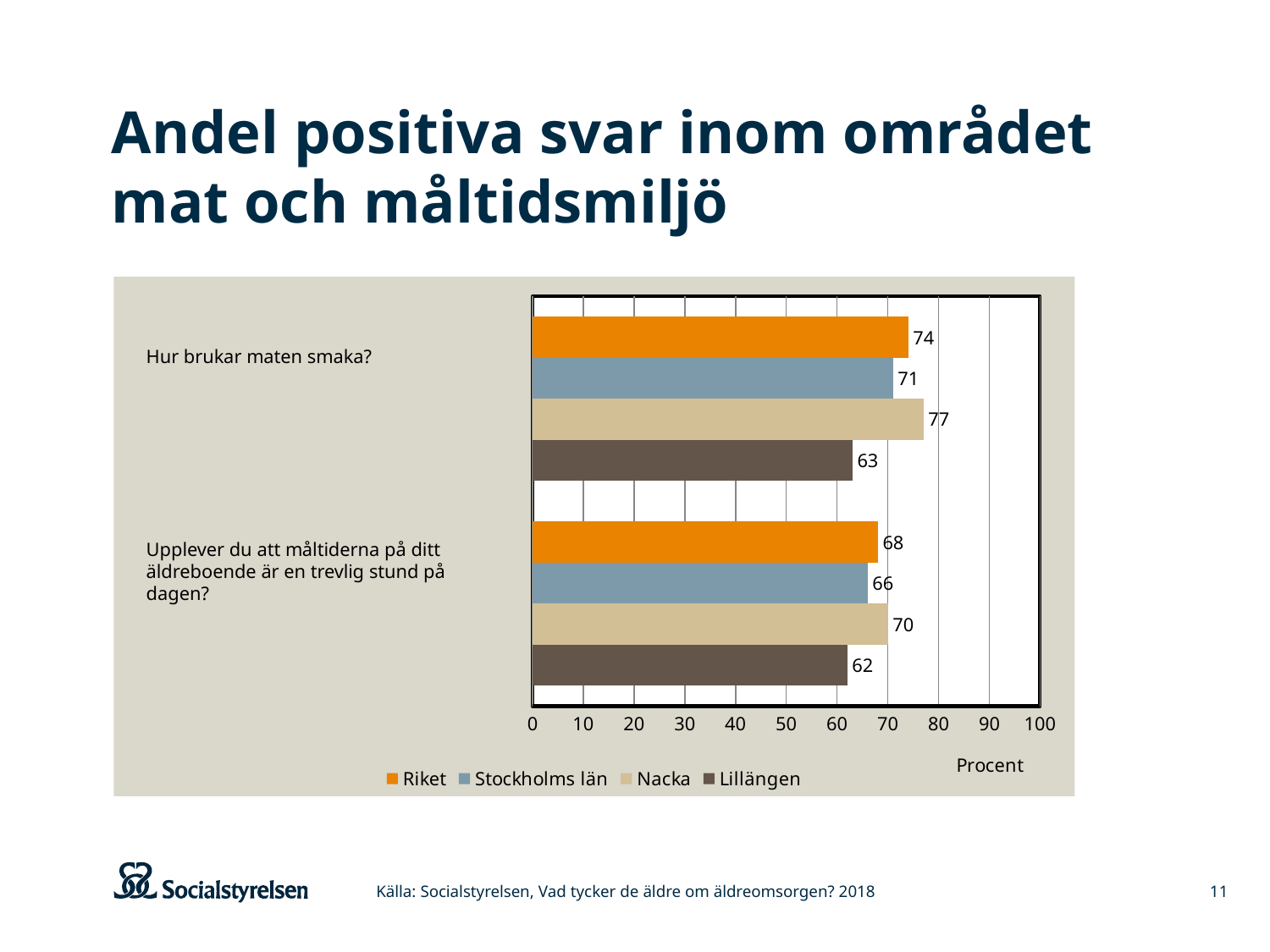
Which series has the lowest value for "Upplever du att måltiderna på ditt äldreboende är en trevlig stund på dagen?"? Lillängen Which series has the highest value for "Hur brukar maten smaka?"? Nacka Which is larger for "Upplever du att måltiderna på ditt äldreboende är en trevlig stund på dagen?": Riket or Nacka? Nacka What is the value for Nacka for the question "Hur brukar maten smaka?"? 77 What is the label of the horizontal axis? Procent What is the difference between the Nacka and Lillängen values for "Hur brukar maten smaka?"? 14 Is the value for Lillängen for "Hur brukar maten smaka?" greater or less than 70? less What is the value for Riket for the question "Hur brukar maten smaka?"? 74 How many series does the legend list? 4 What kind of chart is shown on the slide? Bar chart What is the value for Stockholms län for the question "Upplever du att måltiderna på ditt äldreboende är en trevlig stund på dagen?"? 66 What is the value for Lillängen for the question "Upplever du att måltiderna på ditt äldreboende är en trevlig stund på dagen?"? 62